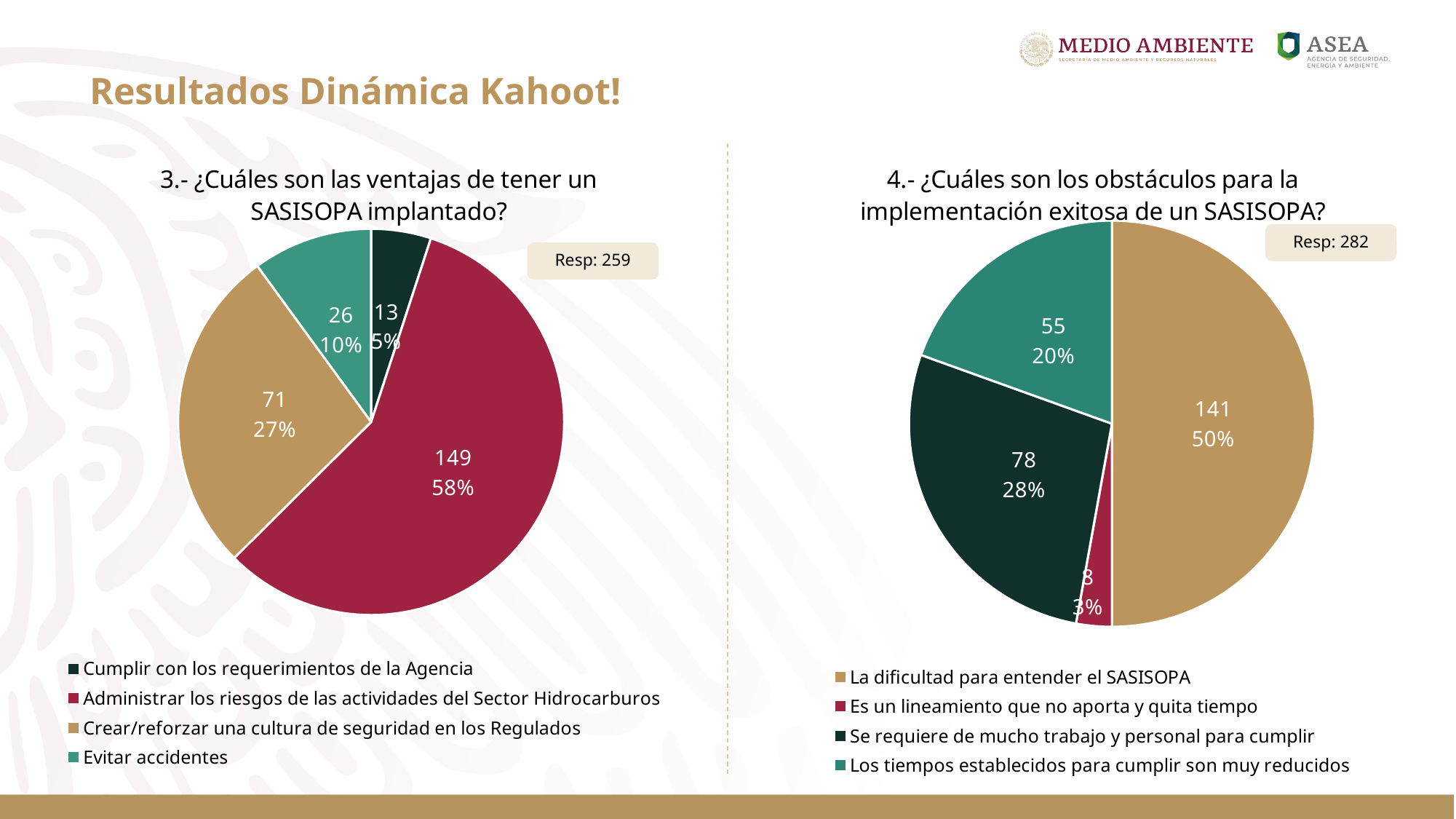
In the left pie chart (question 3), what percentage share does 'Crear/reforzar una cultura de seguridad en los Regulados' have? 27% In the left pie chart (question 3), what is the difference in responses between 'Administrar los riesgos de las actividades del Sector Hidrocarburos' and 'Crear/reforzar una cultura de seguridad en los Regulados'? 78 In the right pie chart (question 4), which has more responses: 'Se requiere de mucho trabajo y personal para cumplir' or 'Los tiempos establecidos para cumplir son muy reducidos'? Se requiere de mucho trabajo y personal para cumplir In the right pie chart (question 4), what percentage share does 'Los tiempos establecidos para cumplir son muy reducidos' have? 20% In the right pie chart (question 4), what is the difference in responses between 'Se requiere de mucho trabajo y personal para cumplir' and 'Es un lineamiento que no aporta y quita tiempo'? 70 What is the total number of responses (Resp) shown for the right pie chart (question 4)? 282 In the right pie chart (question 4), which category has the largest share? La dificultad para entender el SASISOPA What type of chart is used for question 3 on the left side of the slide? Pie chart In the right pie chart (question 4), how many responses chose 'La dificultad para entender el SASISOPA'? 141 How many categories does the legend of the left pie chart (question 3) list? 4 In the left pie chart (question 3), how many responses chose 'Administrar los riesgos de las actividades del Sector Hidrocarburos'? 149 In the left pie chart (question 3), which category has the fewest responses? Cumplir con los requerimientos de la Agencia